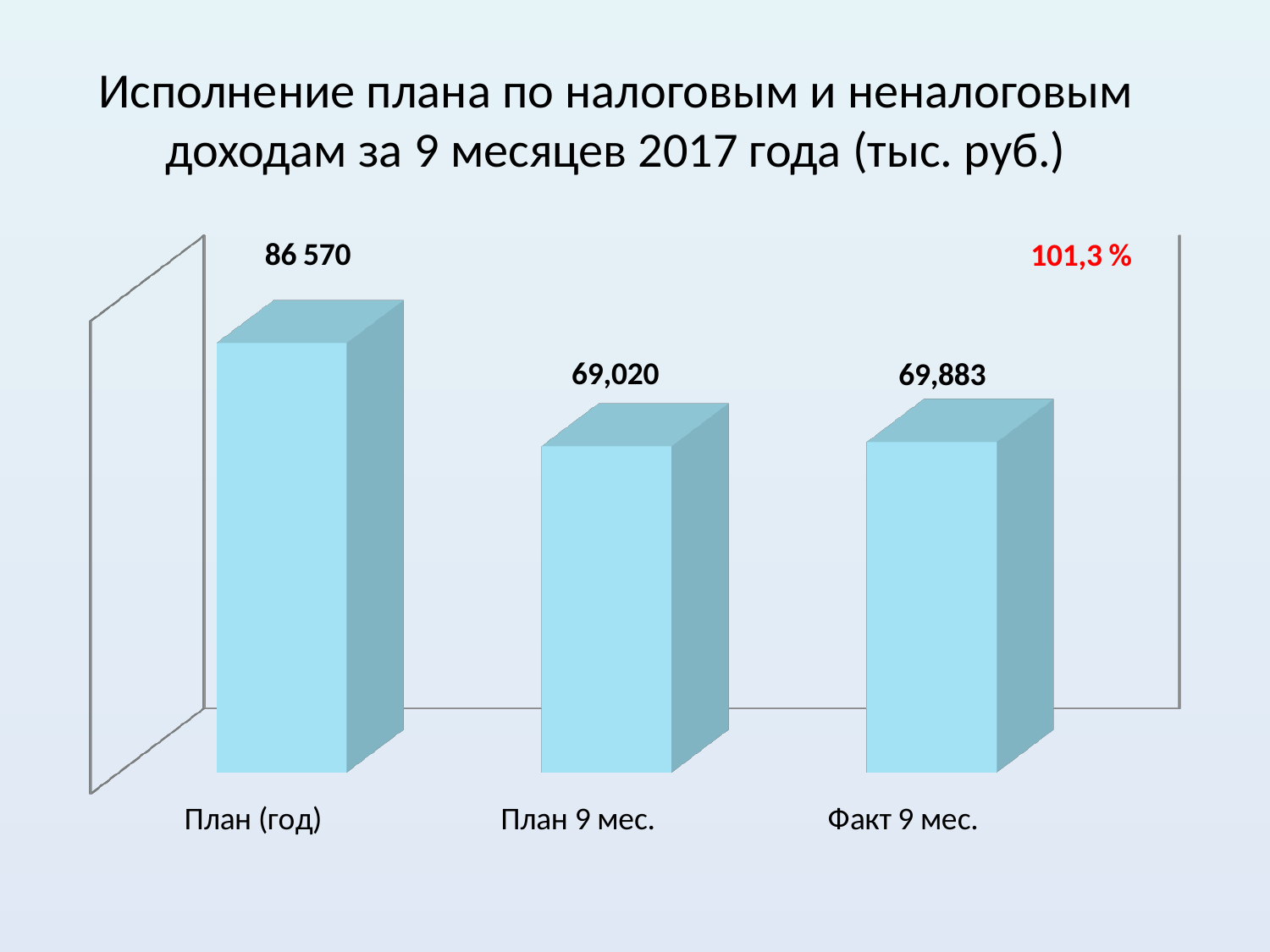
What unit is given in the slide title for the values? тыс. руб. What value is shown for Факт 9 мес.? 69,883 What is the difference between the values for Факт 9 мес. and План 9 мес.? 863 What value is shown for План 9 мес.? 69,020 Which category has the highest value? План (год) Which category has the lowest value? План 9 мес. What value is shown for План (год)? 86 570 How many bars are shown in the chart? 3 What percentage is printed in red in the top right of the chart? 101,3 % What is the difference between the values for План (год) and План 9 мес.? 17,550 Which is larger, the value for План 9 мес. or the value for Факт 9 мес.? Факт 9 мес. What kind of chart is shown on the slide? Bar chart